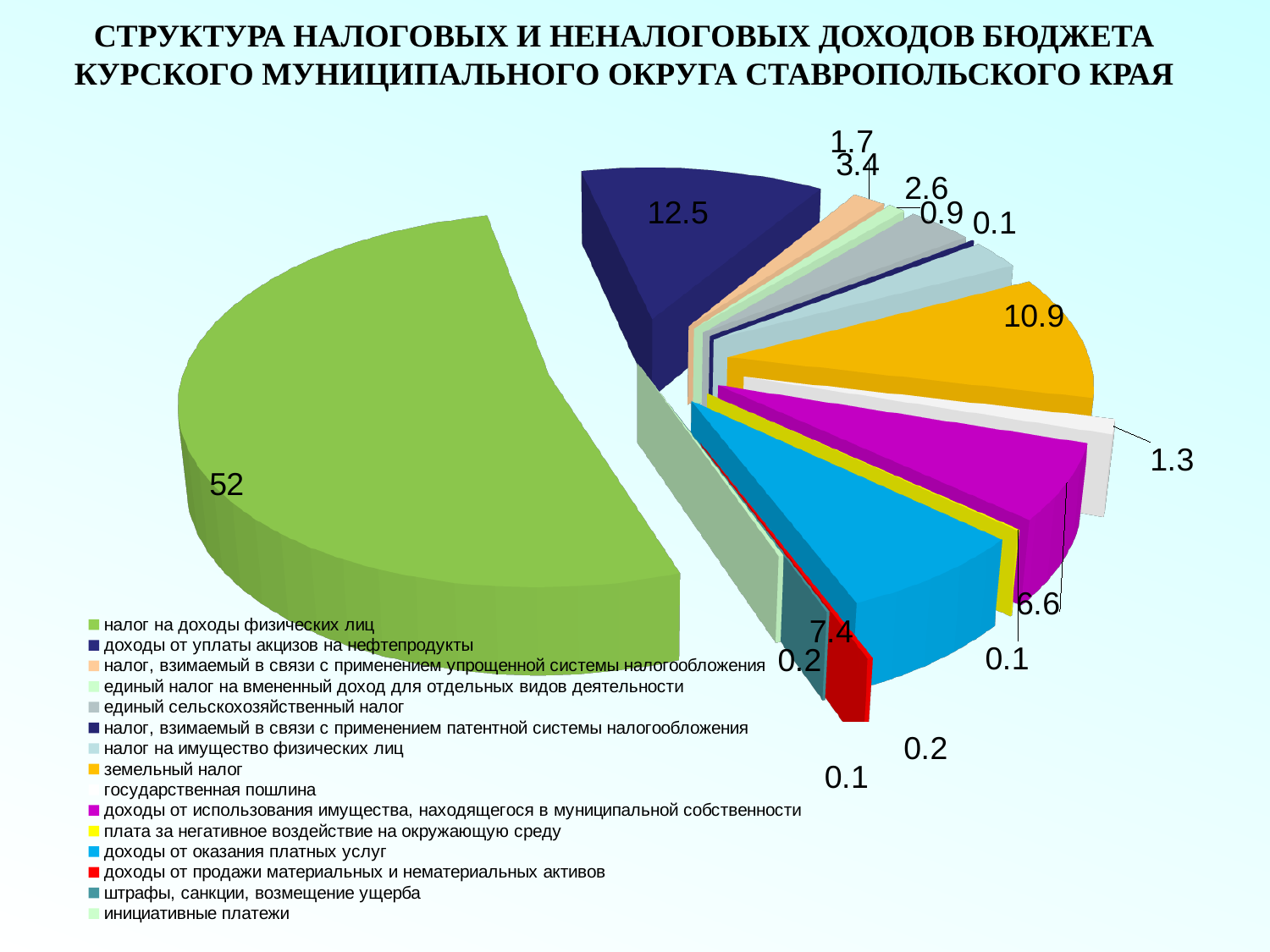
What is the value shown for доходы от оказания платных услуг? 7.4 What colour is the slice for налог на доходы физических лиц? green Which is larger: доходы от уплаты акцизов на нефтепродукты or земельный налог? доходы от уплаты акцизов на нефтепродукты What is the value shown for государственная пошлина? 1.3 What type of chart is shown on the slide? pie chart What is the difference between the values for налог на доходы физических лиц and доходы от уплаты акцизов на нефтепродукты? 39.5 What is the value shown for доходы от уплаты акцизов на нефтепродукты? 12.5 What is the value shown for земельный налог? 10.9 What is the value shown for налог на доходы физических лиц? 52 Which category has the largest slice in the pie chart? налог на доходы физических лиц How many categories does the legend of the pie chart list? 15 What is the value shown for доходы от использования имущества, находящегося в муниципальной собственности? 6.6